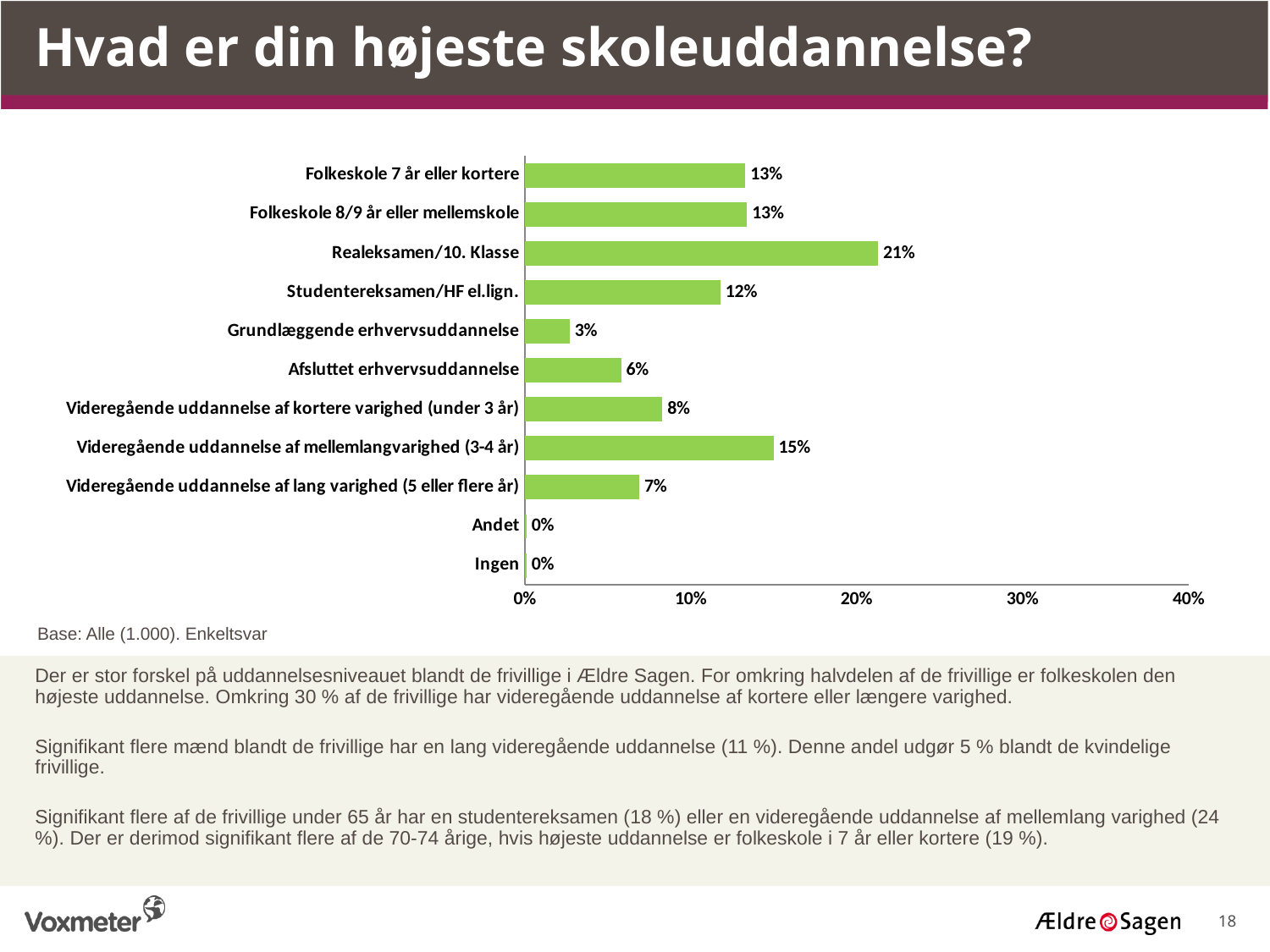
What is the value for Andet? 0% What is the highest value shown on the x axis? 40% Which category has the highest value? Realeksamen/10. Klasse What is the value for Grundlæggende erhvervsuddannelse? 3% Is the value for Realeksamen/10. Klasse greater or less than 20%? greater Which is larger: Afsluttet erhvervsuddannelse or Videregående uddannelse af kortere varighed (under 3 år)? Videregående uddannelse af kortere varighed (under 3 år) How many categories are shown in the chart? 11 What is the difference between Realeksamen/10. Klasse and Studentereksamen/HF el.lign.? 9% What is the value for Realeksamen/10. Klasse? 21% What is the value for Videregående uddannelse af lang varighed (5 eller flere år)? 7% What is the value for Videregående uddannelse af mellemlangvarighed (3-4 år)? 15% What kind of chart is shown on the slide? Bar chart